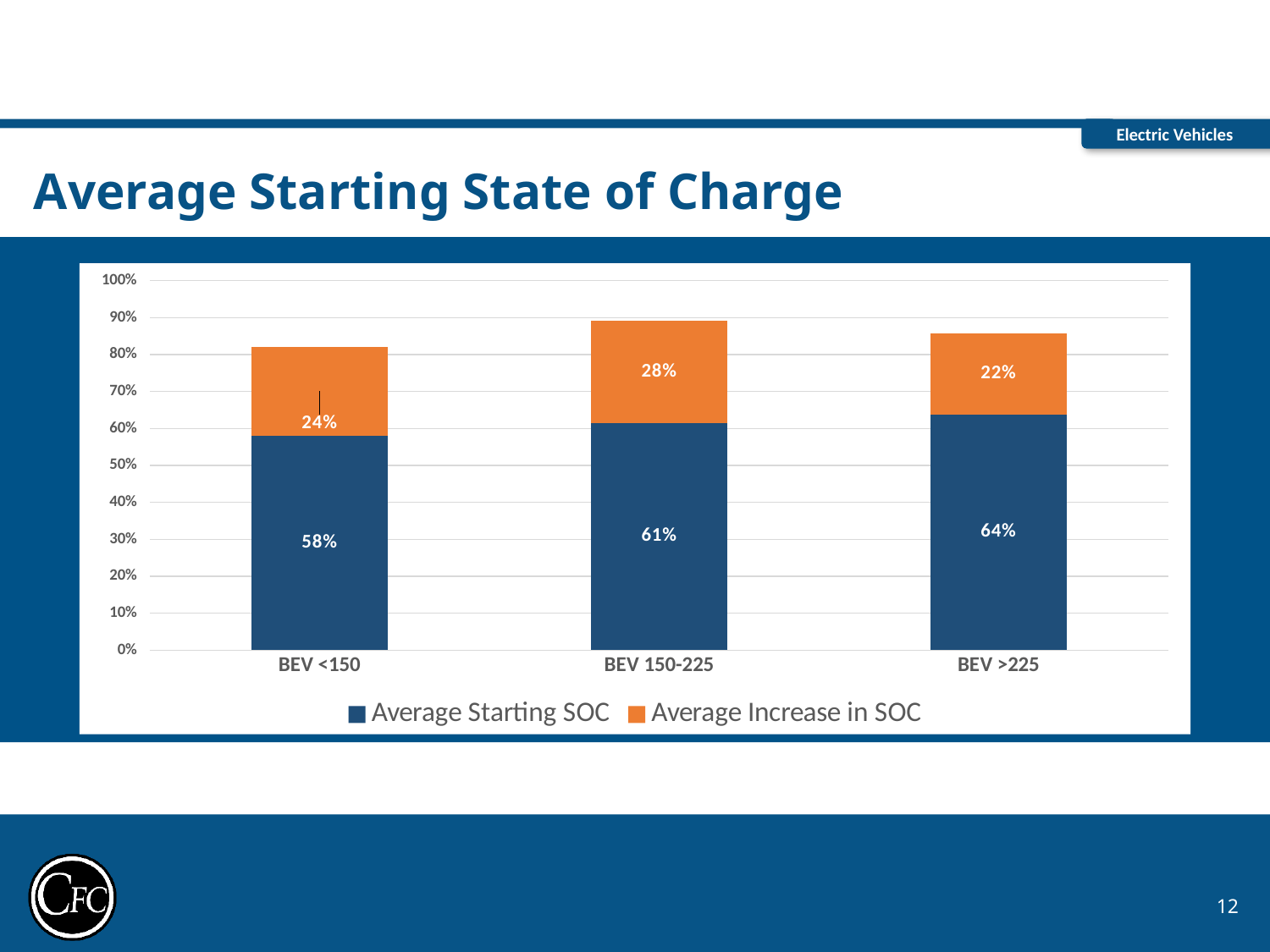
Which category has the highest Average Starting SOC? BEV >225 Which is larger, the Average Increase in SOC for BEV <150 or for BEV 150-225? BEV 150-225 What is the Average Starting SOC for BEV <150? 58% What is the difference between the Average Starting SOC for BEV >225 and BEV <150? 6% Which category has the lowest Average Increase in SOC? BEV >225 What is the Average Starting SOC for BEV >225? 64% How many categories are shown on the x axis? 3 What is the title of the chart on the slide? Average Starting State of Charge What is the total height of the stacked bar for BEV 150-225? 89% How many series does the legend list? 2 What is the Average Increase in SOC for BEV 150-225? 28% What kind of chart is shown on the slide? Stacked bar chart